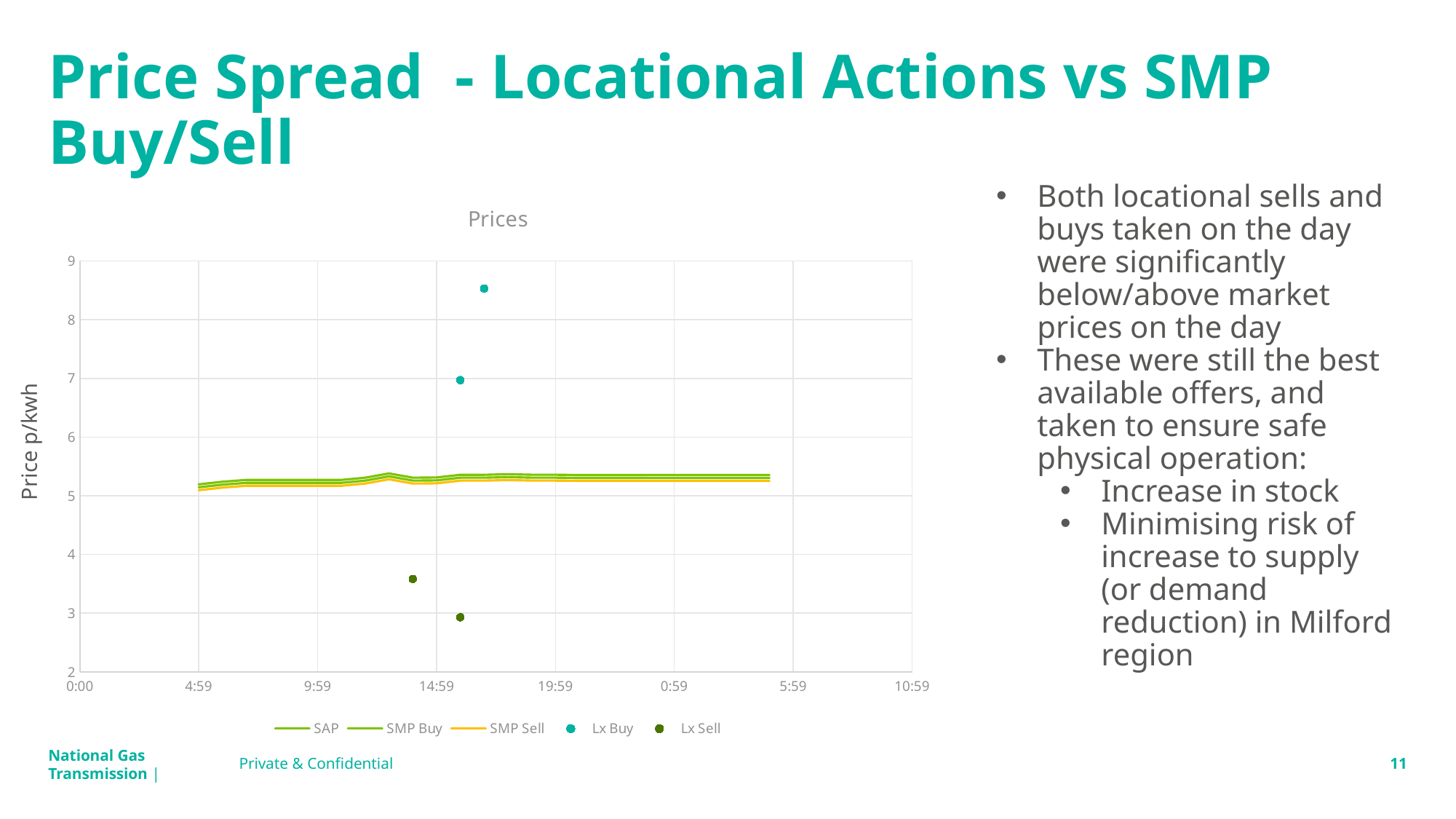
What is the title of the chart? Prices Which series has the highest plotted value on the chart? Lx Buy Which is larger, the SMP Sell line or the Lx Sell points? SMP Sell Is the highest Lx Buy point greater or less than 8? greater What is the label on the vertical axis of the chart? Price p/kwh How many series does the chart legend list? 5 Is the SAP line greater or less than 6 across the plotted period? less How many Lx Buy points are plotted on the chart? 2 Which series has the lowest plotted value on the chart? Lx Sell How many Lx Sell points are plotted on the chart? 2 Which is larger, the Lx Buy points or the SMP Buy line? Lx Buy